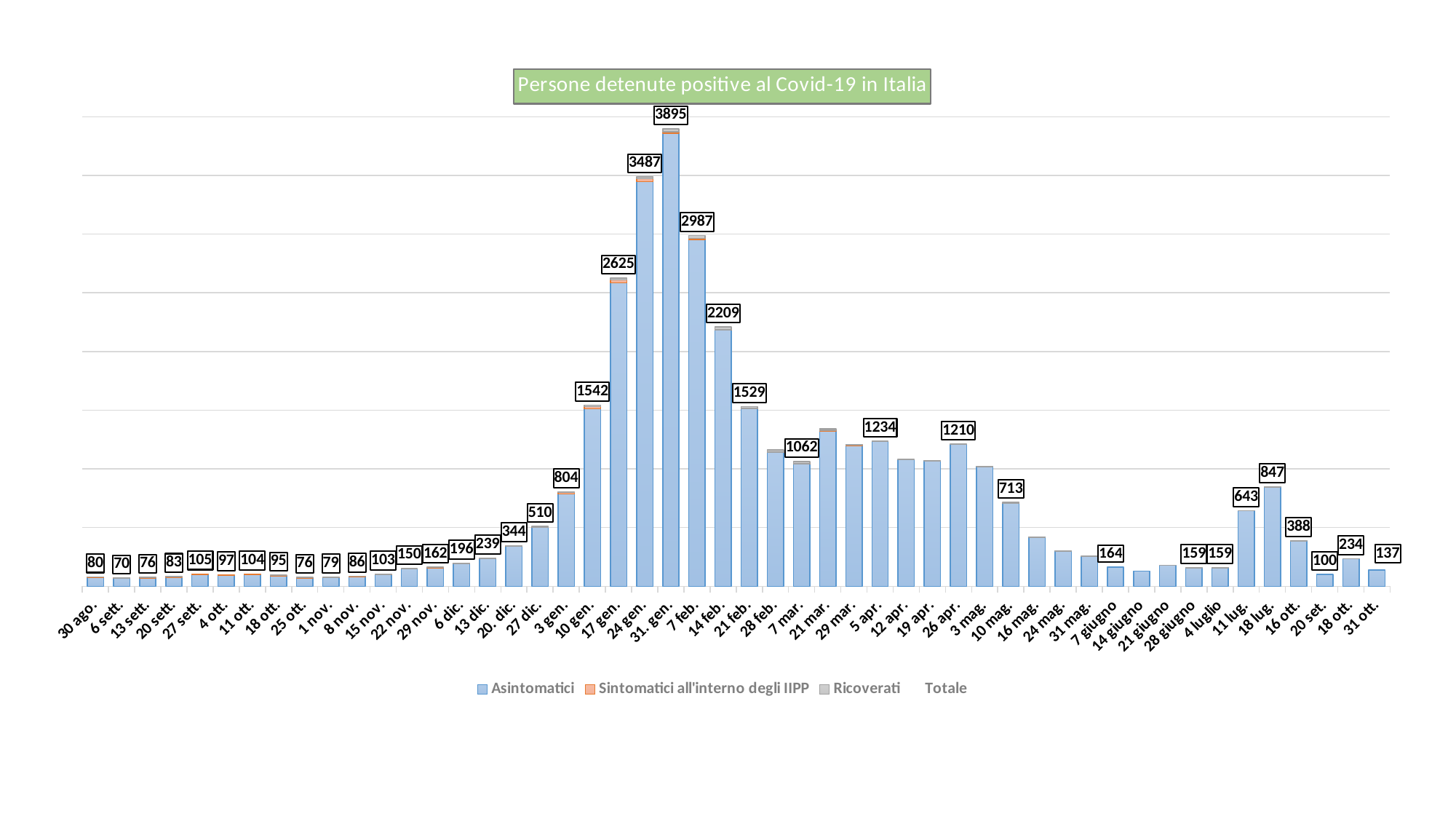
What is the total value shown for 17 gen.? 2625 What is the total value shown for 18 lug.? 847 Which has a larger total, 7 feb. or 17 gen.? 7 feb. What kind of chart is this? Stacked bar chart Do the totals rise or fall from 31. gen. to 21 feb.? Fall How many dates are shown on the x axis? 50 How many series does the legend list? 4 What is the title of the chart? Persone detenute positive al Covid-19 in Italia Which date has the lowest total? 6 sett. What is the total value shown for 31. gen.? 3895 Which date has the highest total? 31. gen. What is the difference between the totals for 31. gen. and 24 gen.? 408